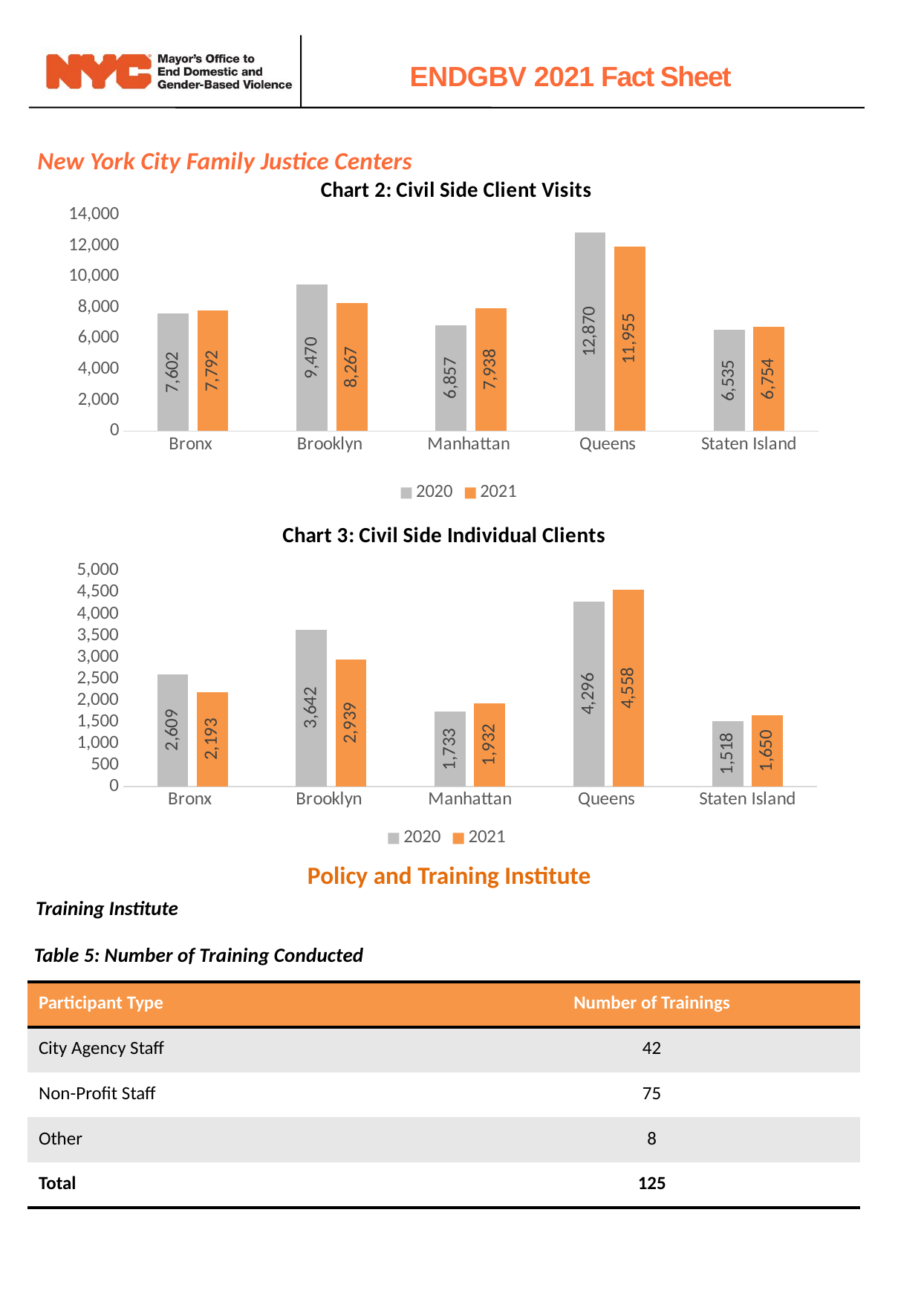
In Chart 2: Civil Side Client Visits, what is the 2021 value for Brooklyn? 8,267 In Chart 3: Civil Side Individual Clients, how many boroughs are shown on the x axis? 5 What kind of chart is Chart 3: Civil Side Individual Clients? Bar chart In Chart 2: Civil Side Client Visits, is the 2020 value for Manhattan greater or less than 8,000? less In Chart 3: Civil Side Individual Clients, what is the difference between the 2020 and 2021 values for Brooklyn? 703 In Chart 3: Civil Side Individual Clients, which is larger for Bronx, the 2020 value or the 2021 value? 2020 In Chart 3: Civil Side Individual Clients, which borough has the lowest 2020 value? Staten Island In Chart 3: Civil Side Individual Clients, what is the 2020 value for Manhattan? 1,733 In Chart 2: Civil Side Client Visits, how many series does the legend list? 2 In Chart 2: Civil Side Client Visits, which borough has the lowest 2021 value? Staten Island In Chart 2: Civil Side Client Visits, what is the difference between the 2020 and 2021 values for Queens? 915 In Chart 2: Civil Side Client Visits, which borough has the highest 2020 value? Queens